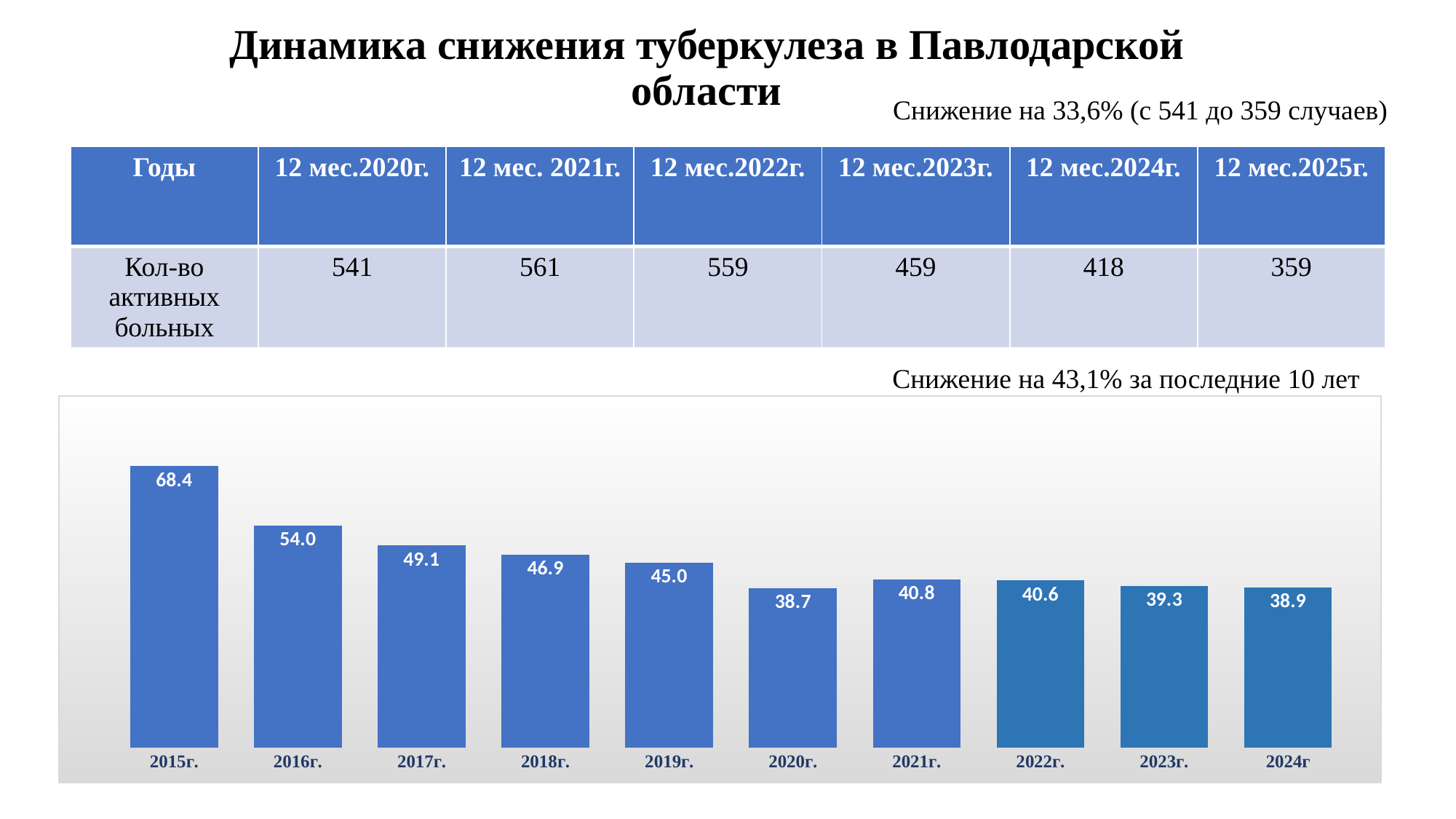
In the bar chart, what is the value for 2024г? 38.9 In the bar chart, which year has the lowest value? 2020г. How many bars are in the bar chart? 10 In the bar chart, what is the value for 2018г.? 46.9 In the bar chart, what is the difference between the values for 2015г. and 2024г? 29.5 In the bar chart, which year has the highest value? 2015г. In the bar chart, which is larger, the value for 2020г. or the value for 2021г.? 2021г. What kind of chart is shown at the bottom of the slide? bar chart In the bar chart, do the values generally rise or fall from 2015г. to 2024г? fall In the bar chart, what is the difference between the values for 2016г. and 2017г.? 4.9 In the bar chart, what is the value for 2015г.? 68.4 In the bar chart, what is the value for 2020г.? 38.7